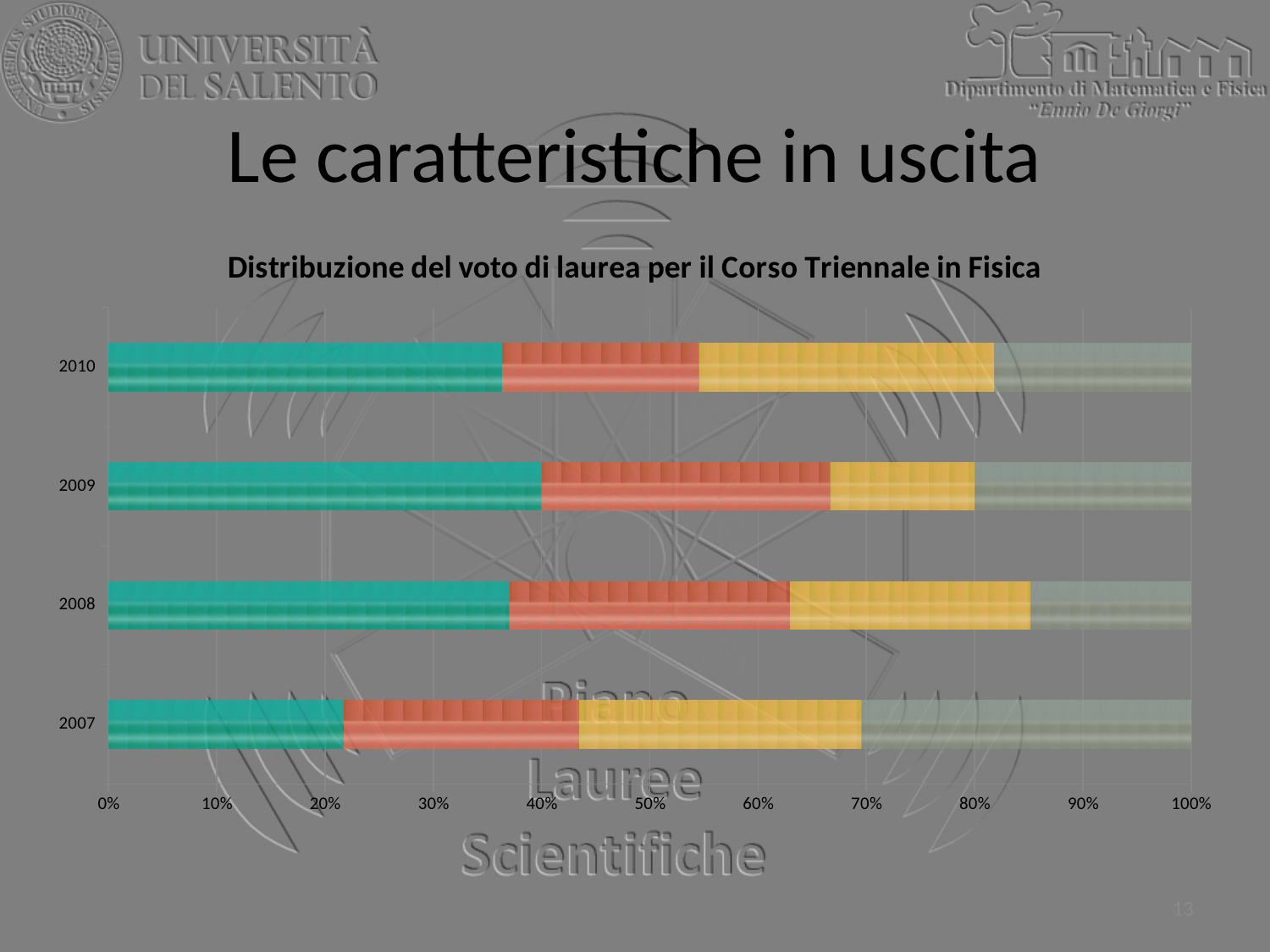
How many years (categories) are shown on the vertical axis of the chart? 4 What is the maximum value shown on the horizontal axis? 100% Does the red (second) segment for 2007 end before or after the 50% mark on the axis? before What is the title of the chart? Distribuzione del voto di laurea per il Corso Triennale in Fisica What kind of chart is shown on the slide? Stacked bar chart Is the teal (first) segment for 2009 greater or less than 30%? greater Is the teal (first) segment for 2008 greater or less than 50%? less Which years are shown as categories on the chart? 2007, 2008, 2009, 2010 Which year has the shortest teal (first) segment? 2007 Is the teal segment for 2009 larger or smaller than the teal segment for 2007? larger